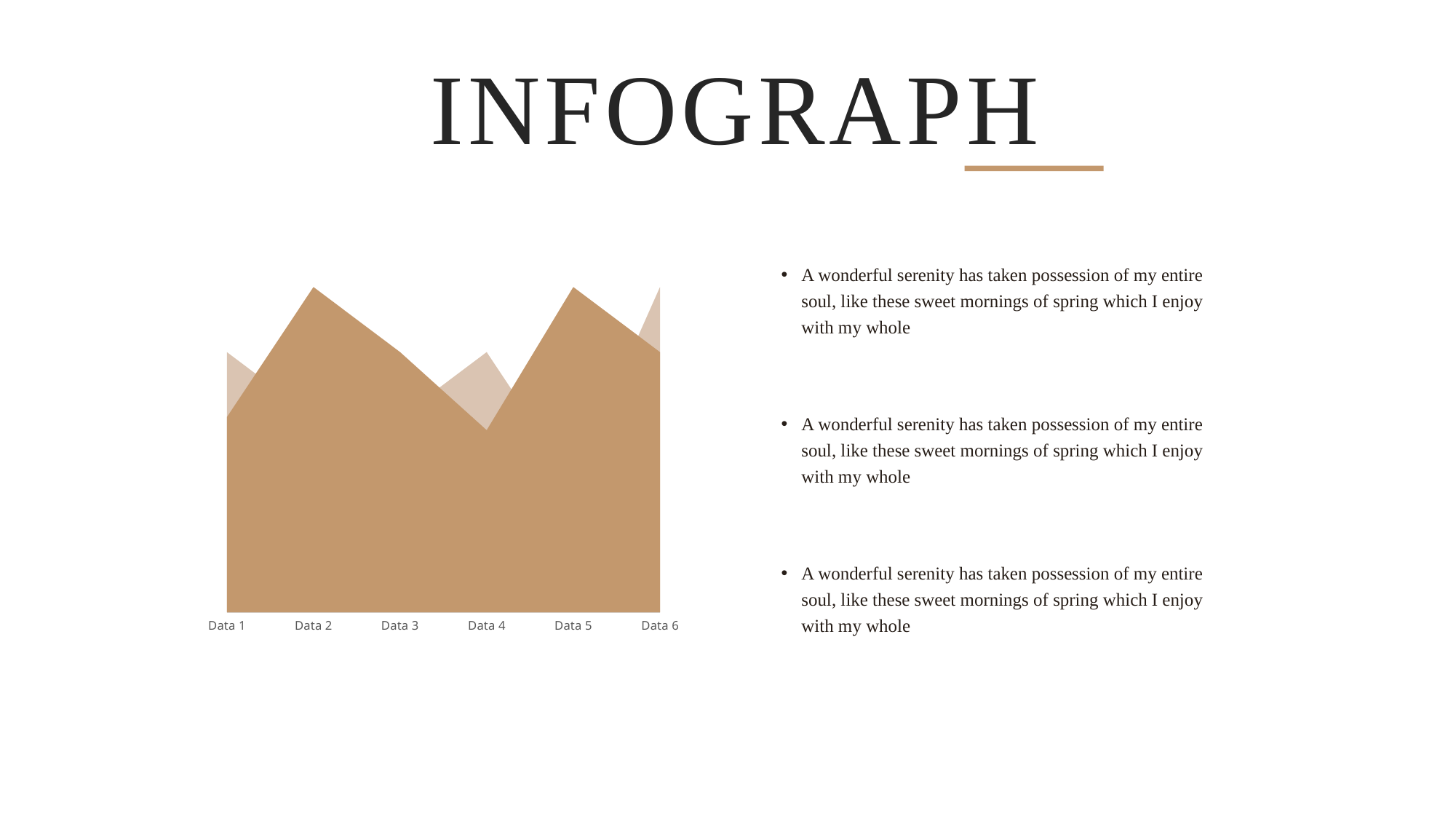
What is the label of the last category on the x axis? Data 6 For the darker brown series, is the value at Data 2 or at Data 4 larger? Data 2 What is the label of the first category on the x axis? Data 1 How many categories are shown along the x axis of the chart? 6 For the darker brown series, do the values rise or fall from Data 4 to Data 5? Rise What kind of chart is shown on the slide? Area chart For the darker brown series, do the values rise or fall from Data 2 to Data 4? Fall For the lighter beige series, is the value at Data 6 or at Data 1 larger? Data 6 For the darker brown series, which category has the lowest value? Data 4 For the darker brown series, do the values rise or fall from Data 1 to Data 2? Rise For the darker brown series, is the value at Data 5 or at Data 3 larger? Data 5